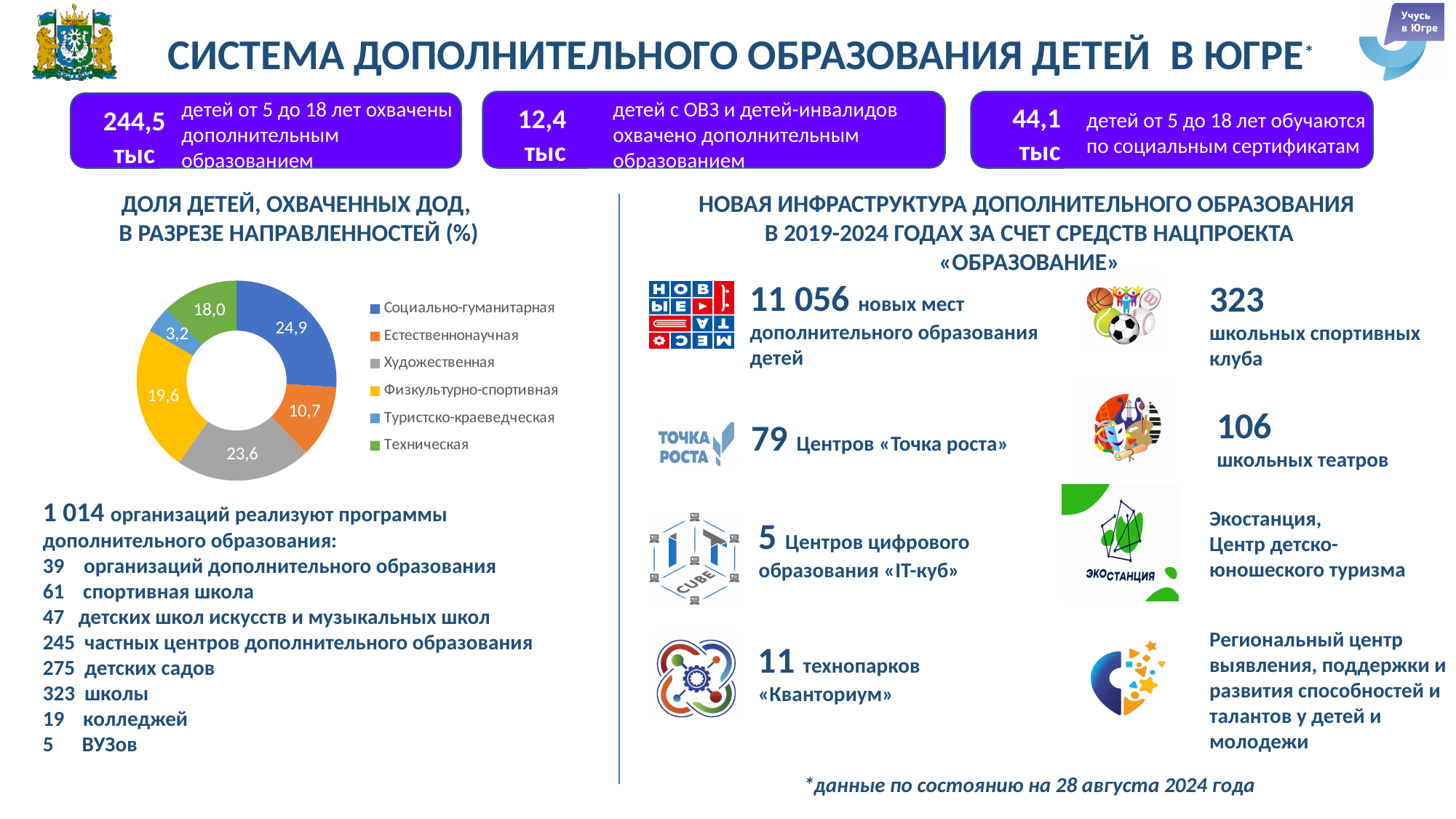
Which category has the largest share in the doughnut chart? Социально-гуманитарная What colour represents Физкультурно-спортивная in the doughnut chart? yellow Which is larger in the doughnut chart: Естественнонаучная or Техническая? Техническая Which category has the smallest share in the doughnut chart? Туристско-краеведческая What is the value for Физкультурно-спортивная in the doughnut chart? 19,6 What is the value for Социально-гуманитарная in the doughnut chart? 24,9 What is the value for Туристско-краеведческая in the doughnut chart? 3,2 How many categories does the doughnut chart show? 6 What kind of chart is shown on the slide? doughnut chart What is the difference between the values for Физкультурно-спортивная and Туристско-краеведческая? 16,4 What is the value for Художественная in the doughnut chart? 23,6 What share of the doughnut chart does Техническая take? 18,0